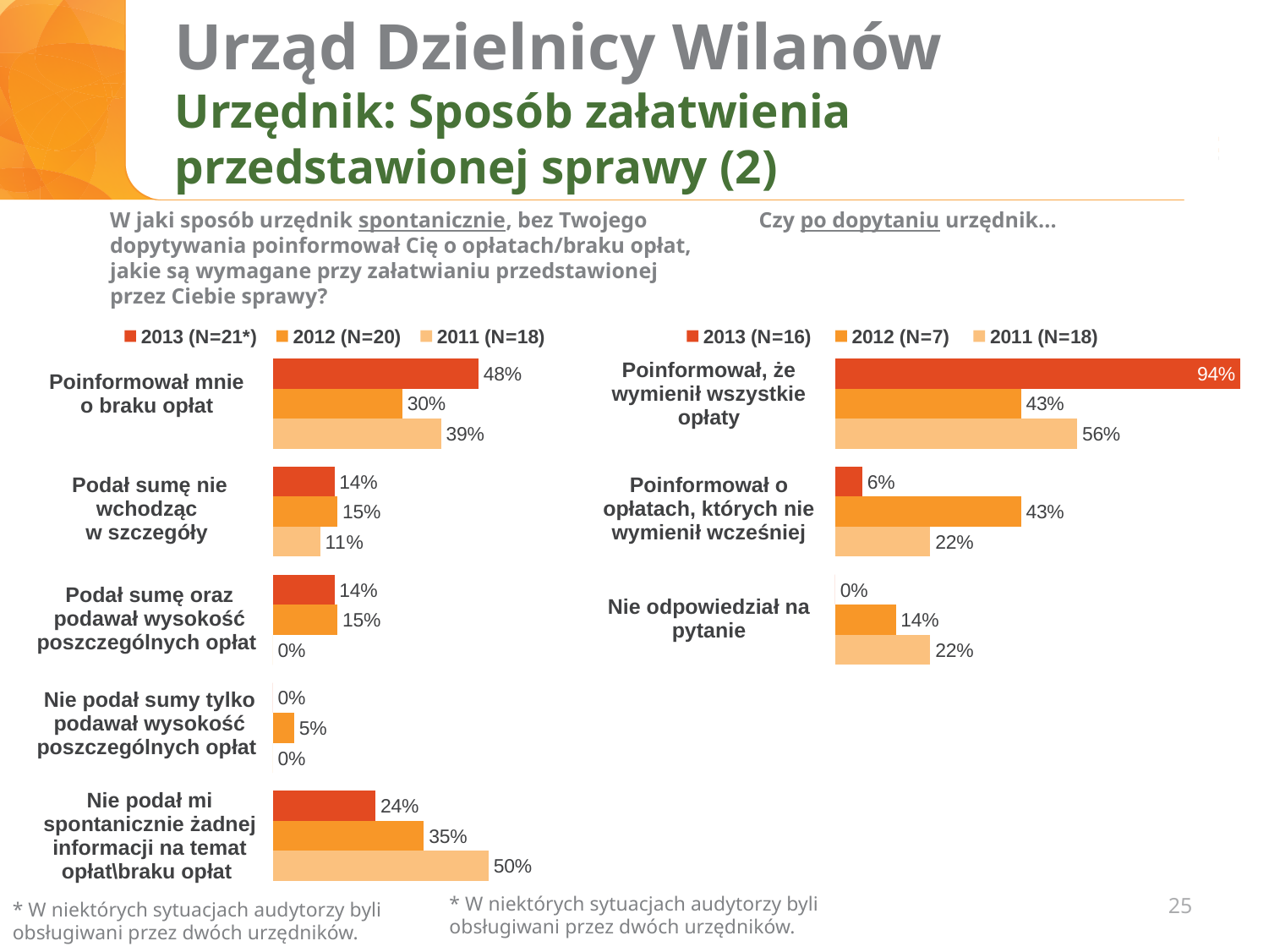
In the right chart ("Czy po dopytaniu urzędnik..."), what is the difference between the 2013 and 2011 values for "Poinformował, że wymienił wszystkie opłaty"? 38% In the left chart (spontaneous information about fees), which category has the highest 2013 value? Poinformował mnie o braku opłat What type of chart is the right chart ("Czy po dopytaniu urzędnik...")? Bar chart In the right chart ("Czy po dopytaniu urzędnik..."), what is the 2012 value for "Nie odpowiedział na pytanie"? 14% How many categories does the left chart (spontaneous information about fees) show? 5 In the left chart (spontaneous information about fees), what is the 2011 value for "Nie podał mi spontanicznie żadnej informacji na temat opłat\braku opłat"? 50% In the right chart ("Czy po dopytaniu urzędnik..."), what is the 2013 value for "Poinformował, że wymienił wszystkie opłaty"? 94% In the left chart (spontaneous information about fees), what is the 2013 value for "Poinformował mnie o braku opłat"? 48% How many series does the legend of the right chart ("Czy po dopytaniu urzędnik...") list? 3 In the left chart (spontaneous information about fees), which is larger for "Nie podał mi spontanicznie żadnej informacji na temat opłat\braku opłat": the 2012 value or the 2013 value? 2012 In the left chart (spontaneous information about fees), what is the difference between the 2013 and 2012 values for "Poinformował mnie o braku opłat"? 18% In the right chart ("Czy po dopytaniu urzędnik..."), which category has the lowest 2013 value? Nie odpowiedział na pytanie